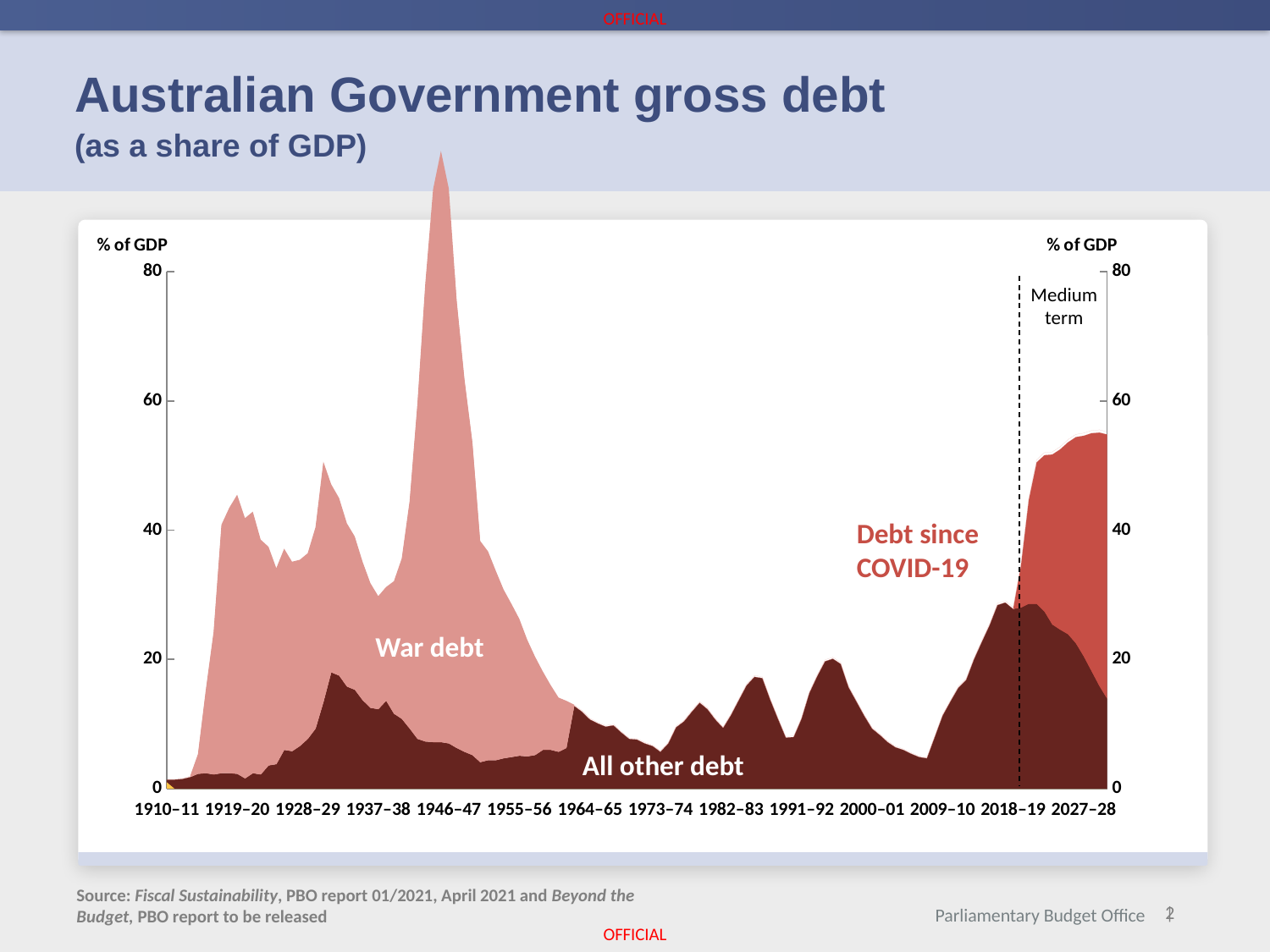
How many debt categories are labelled in the chart? 3 Is the gross debt in 2018–19 greater or less than 20% of GDP? greater Is the gross debt in 1973–74 greater or less than 20% of GDP? less Is the total gross debt in 2027–28 greater or less than 60% of GDP? less What kind of chart is shown on the slide? Area chart Does total gross debt rise or fall between 2009–10 and 2027–28? rise How many year labels are shown on the horizontal axis? 14 What are the three debt categories labelled in the chart? War debt, All other debt, Debt since COVID-19 What unit is shown on the vertical axis of the chart? % of GDP